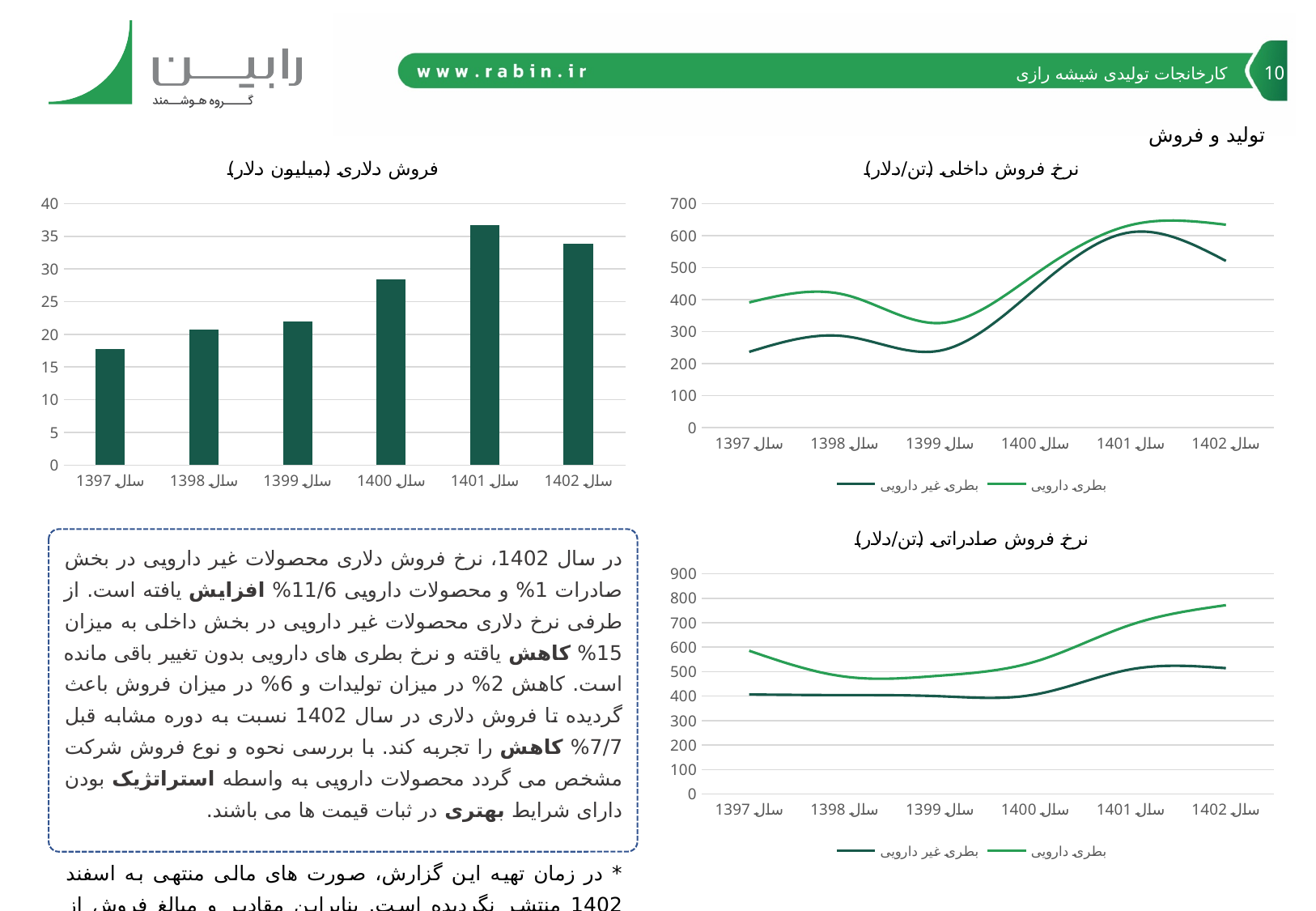
How many series does the legend of the 'نرخ فروش داخلی (تن/دلار)' chart list? 2 In the 'فروش دلاری (میلیون دلار)' chart, which year has the lowest value? سال 1397 In the 'نرخ فروش داخلی (تن/دلار)' chart, which series is higher in سال 1402, بطری دارویی or بطری غیر دارویی? بطری دارویی In the 'نرخ فروش صادراتی (تن/دلار)' chart, which year has the highest value for بطری دارویی? سال 1402 What kind of chart is the 'فروش دلاری (میلیون دلار)' chart? bar chart How many bars are shown in the 'فروش دلاری (میلیون دلار)' chart? 6 In the 'فروش دلاری (میلیون دلار)' chart, is the value for سال 1397 greater or less than 20? less In the 'نرخ فروش داخلی (تن/دلار)' chart, is the value for بطری غیر دارویی in سال 1401 greater or less than 500? greater In the 'فروش دلاری (میلیون دلار)' chart, is the value for سال 1401 greater or less than 35? greater In the 'نرخ فروش داخلی (تن/دلار)' chart, which year has the lowest value for بطری دارویی? سال 1399 In the 'فروش دلاری (میلیون دلار)' chart, which year has the highest value? سال 1401 In the 'نرخ فروش صادراتی (تن/دلار)' chart, does the value for بطری دارویی rise or fall from سال 1399 to سال 1402? rise